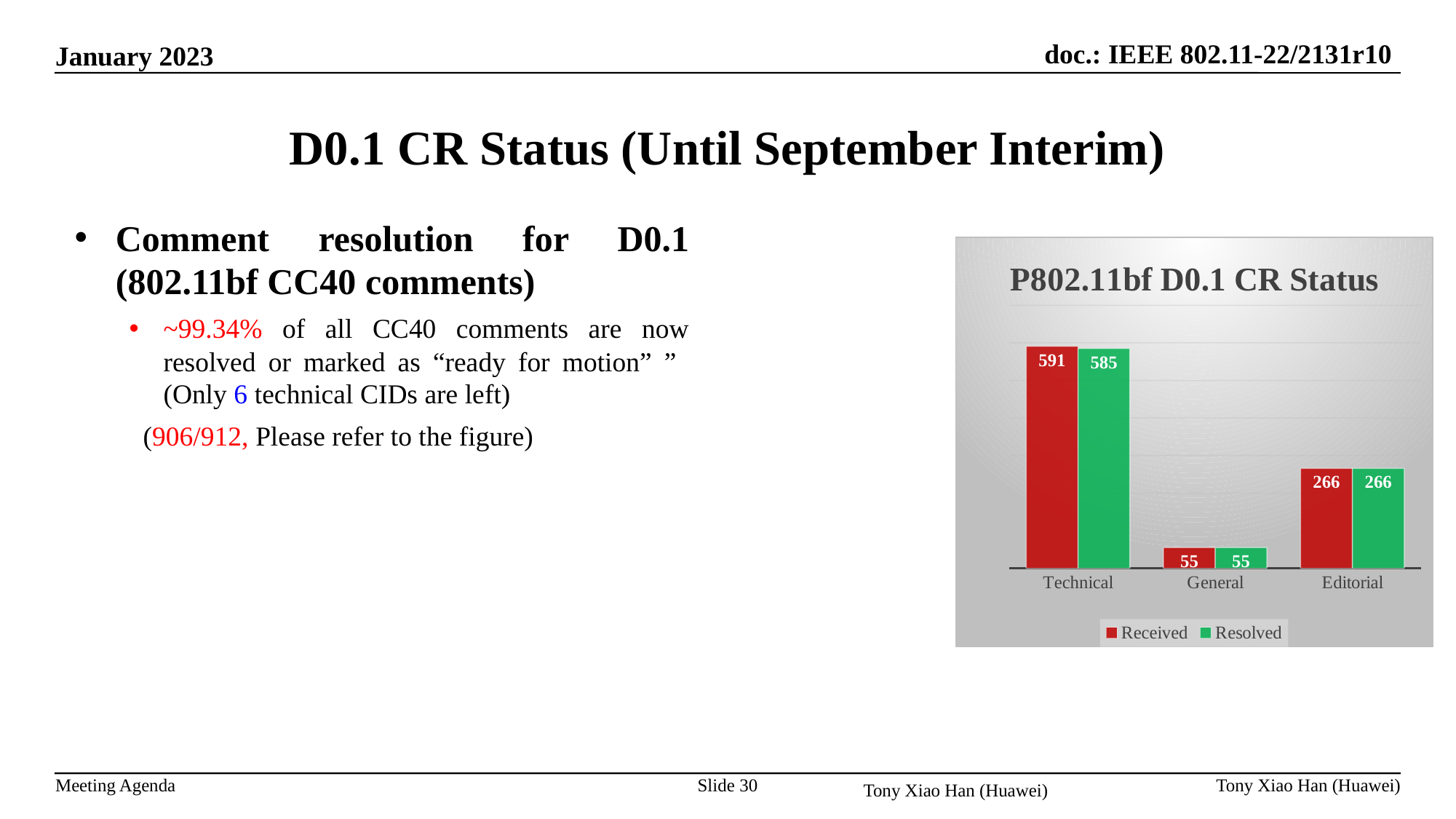
How many categories are shown on the x axis? 3 Which category has the lowest Resolved value? General Which is larger, the Received value for Editorial or the Received value for General? Editorial What is the difference between the Received values for Technical and Editorial? 325 What is the title of the chart? P802.11bf D0.1 CR Status How many series does the legend list? 2 What is the Resolved value for Technical? 585 What is the Received value for Technical? 591 Which category has the highest Received value? Technical What is the Resolved value for Editorial? 266 What is the Received value for General? 55 What is the difference between the Received and Resolved values for Technical? 6